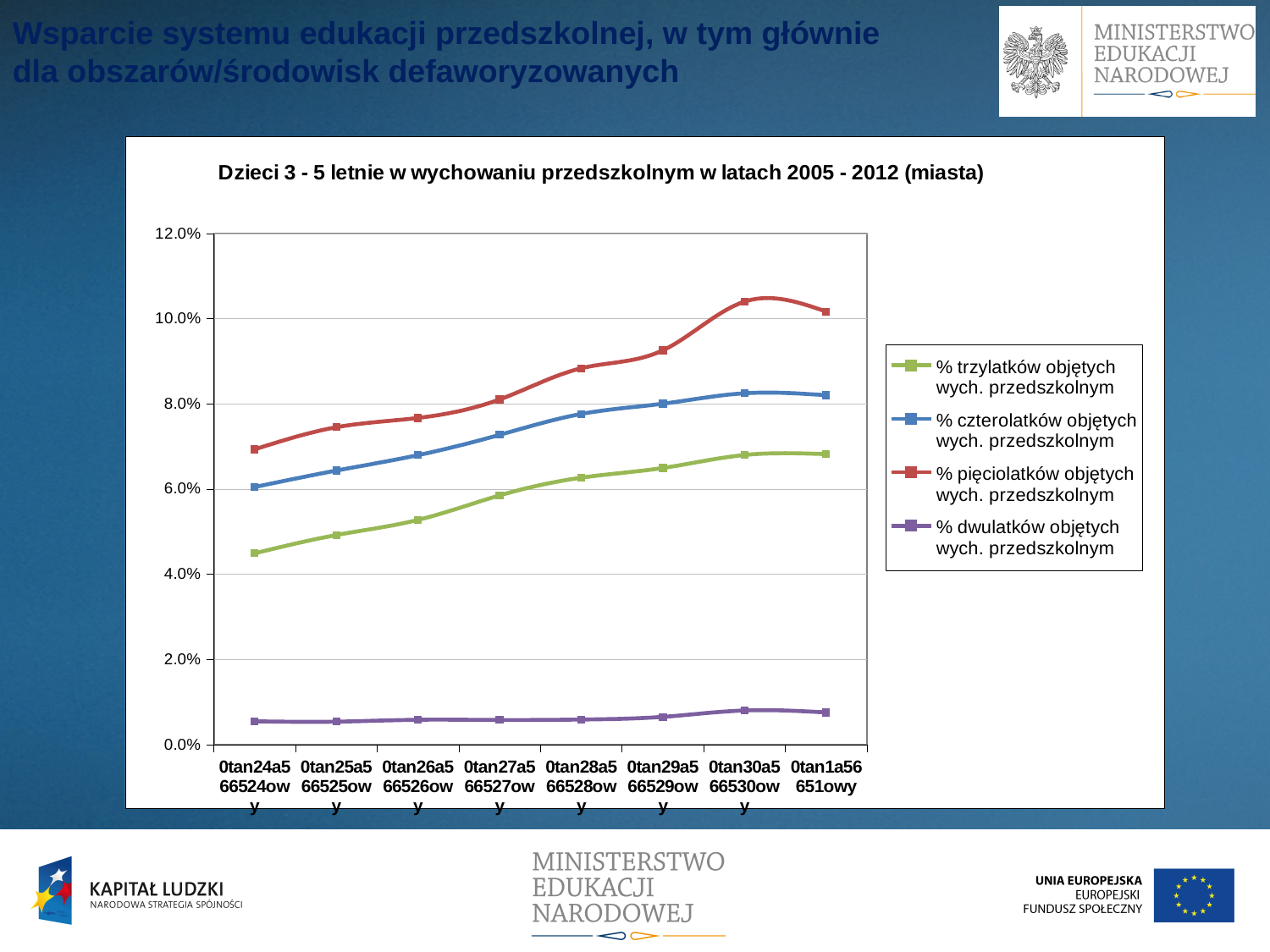
Is the first value of the '% trzylatków objętych wych. przedszkolnym' series greater or less than 4.0%? greater Are the values of the '% dwulatków objętych wych. przedszkolnym' series greater or less than 2.0%? less Does the '% trzylatków objętych wych. przedszkolnym' line generally rise or fall from left to right? rise What kind of chart is shown on the slide? line chart Is the first value of the '% pięciolatków objętych wych. przedszkolnym' series greater or less than 6.0%? greater At the first point on the x axis, which is larger: the '% pięciolatków' series or the '% trzylatków' series? % pięciolatków objętych wych. przedszkolnym Which series has the lowest values throughout the chart? % dwulatków objętych wych. przedszkolnym Which series has the highest values throughout the chart? % pięciolatków objętych wych. przedszkolnym What is the title of the chart? Dzieci 3 - 5 letnie w wychowaniu przedszkolnym w latach 2005 - 2012 (miasta) How many data points does each line have? 8 How many series does the legend list? 4